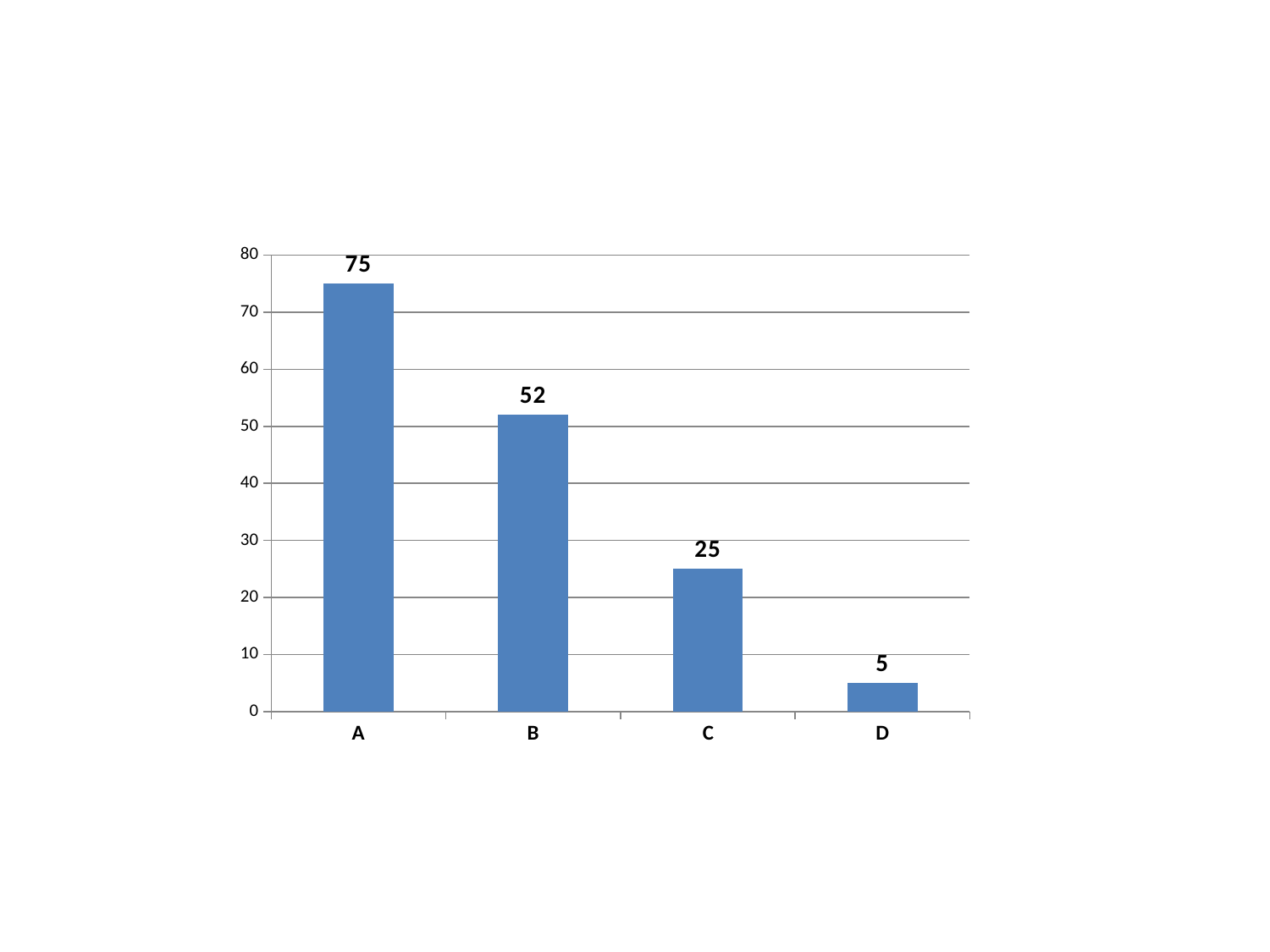
Which category has the lowest value? D What is the value for category A? 75 Which is larger, the value for B or the value for C? B What is the value for category D? 5 What kind of chart is shown on the slide? Bar chart Which category has the highest value? A Is the value for B greater or less than 50? greater What is the value for category C? 25 What is the difference between the values for A and B? 23 What is the difference between the values for C and D? 20 What is the value for category B? 52 How many categories are shown on the x axis? 4